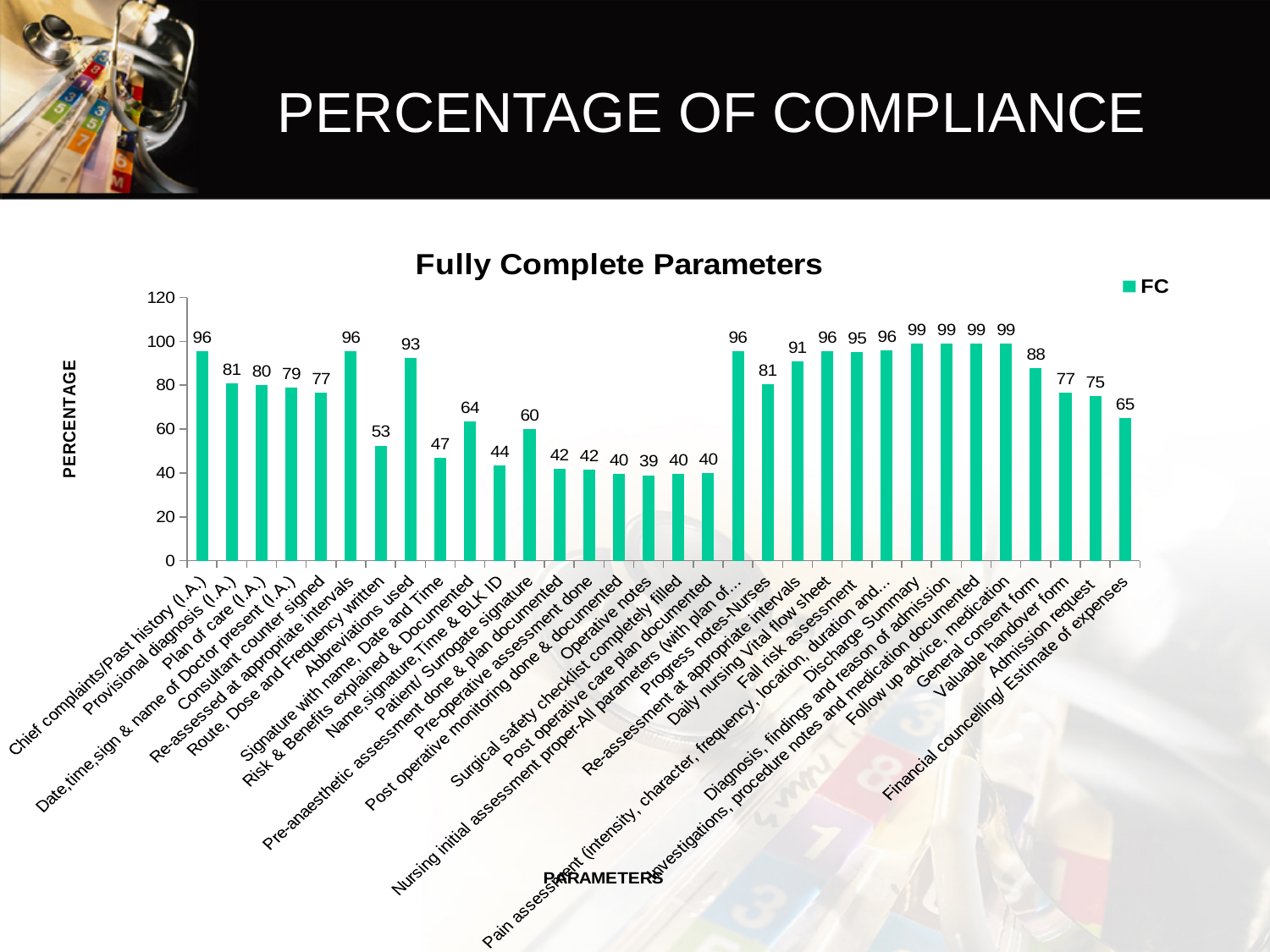
What is the highest value shown on the chart? 99 How many categories are plotted on the chart? 32 Which is larger, the value for Route, Dose and Frequency written or the value for Patient/ Surrogate signature? Patient/ Surrogate signature What is the difference between the values for Discharge Summary and Admission request? 24 How many series does the legend list? 1 What is the value for Abbreviations used? 93 What is the value for Financial councelling/ Estimate of expenses? 65 Which category has the lowest value? Operative notes What is the value for General consent form? 88 What is the title of the chart? Fully Complete Parameters What is the value for Operative notes? 39 What type of chart is shown on the slide? Bar chart